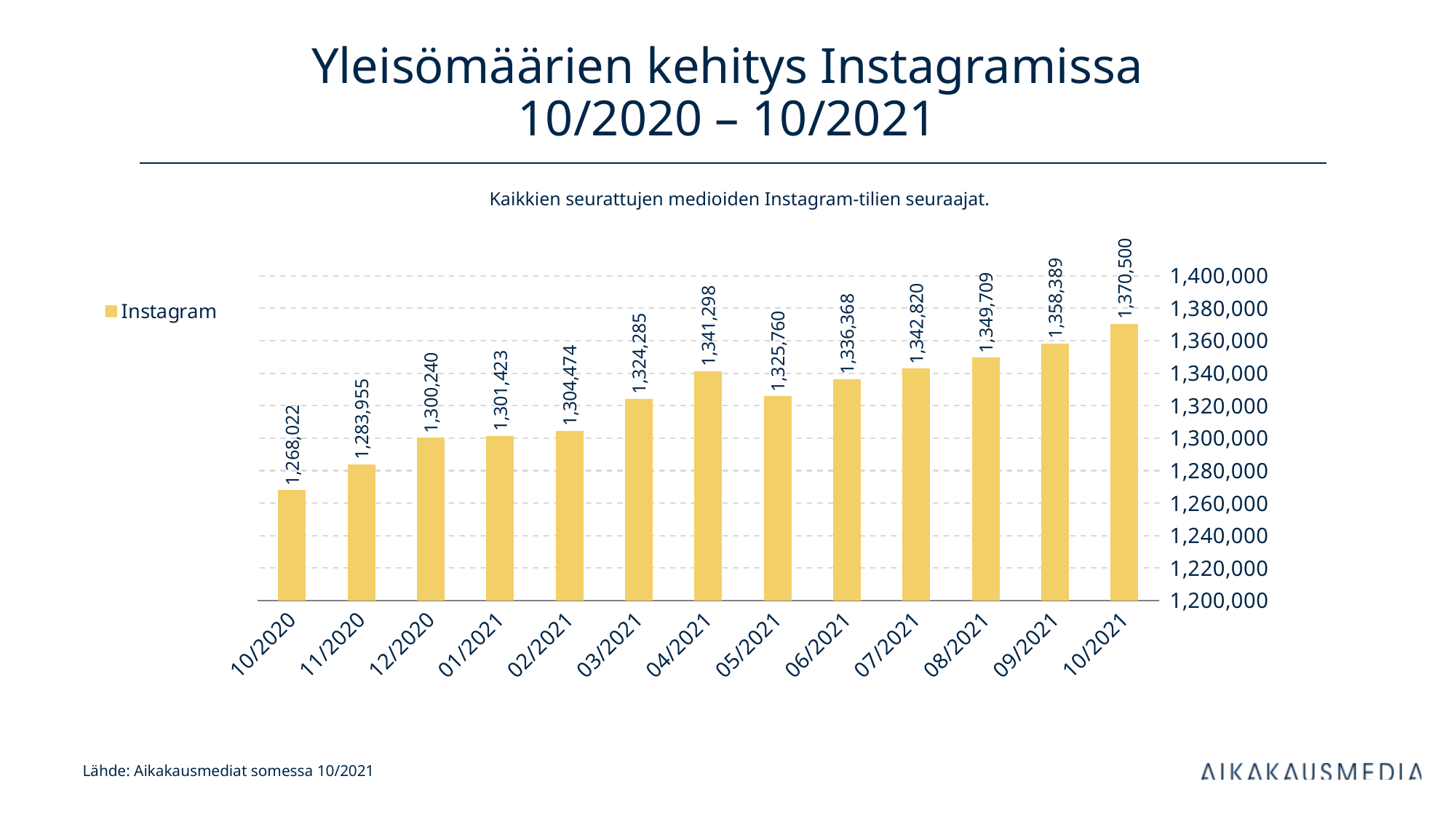
What is the difference between the values for 10/2021 and 10/2020? 102,478 What kind of chart is shown on the slide? bar chart Which month has the lowest value? 10/2020 Which is larger, the value for 04/2021 or the value for 05/2021? 04/2021 What is the difference between the values for 04/2021 and 05/2021? 15,538 What is the value for 10/2021? 1,370,500 How many months are shown on the x axis? 13 Which month has the highest value? 10/2021 What is the value for 10/2020? 1,268,022 Is the value for 03/2021 greater or less than 1,300,000? greater What series name does the legend show? Instagram What is the value for 04/2021? 1,341,298